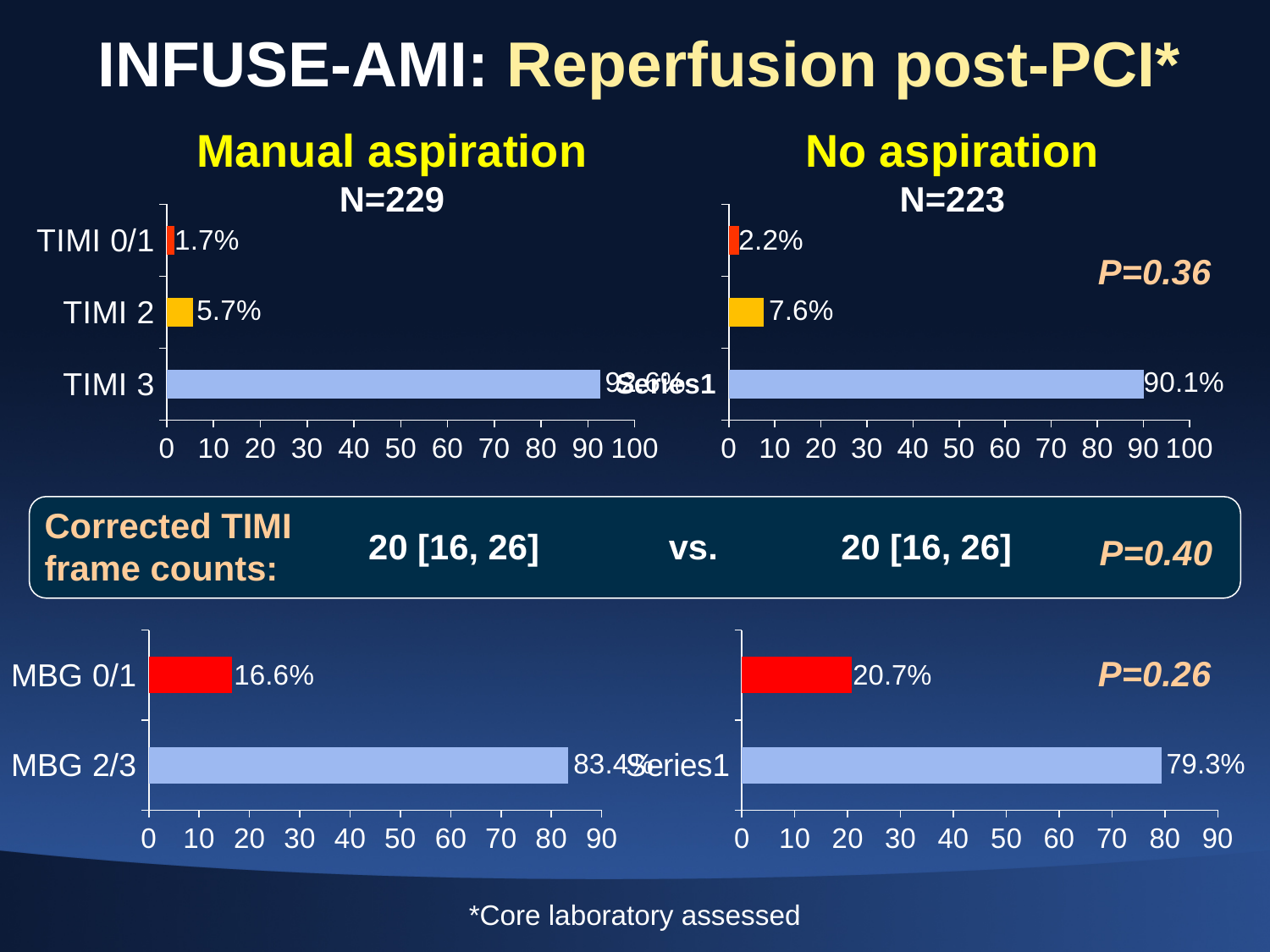
How many categories are shown in the top-left chart (Manual aspiration, TIMI)? 3 In the bottom-right chart (No aspiration, MBG), what is the value for MBG 2/3? 79.3% In the top-right chart (No aspiration, TIMI), which category has the highest value? TIMI 3 In the top-left chart (Manual aspiration, TIMI), what is the value for TIMI 0/1? 1.7% In the bottom-right chart (No aspiration, MBG), what is the difference between MBG 2/3 and MBG 0/1? 58.6% What kind of chart is the bottom-left chart (Manual aspiration, MBG)? Bar chart In the bottom-left chart (Manual aspiration, MBG), what is the value for MBG 0/1? 16.6% In the top-left chart (Manual aspiration, TIMI), is the value for TIMI 3 greater or less than 90? greater In the top-right chart (No aspiration, TIMI), what is the value for TIMI 2? 7.6% In the top-left chart (Manual aspiration, TIMI), which category has the lowest value? TIMI 0/1 In the top-right chart (No aspiration, TIMI), what is the value for TIMI 3? 90.1% In the top-left chart (Manual aspiration, TIMI), what is the value for TIMI 2? 5.7%